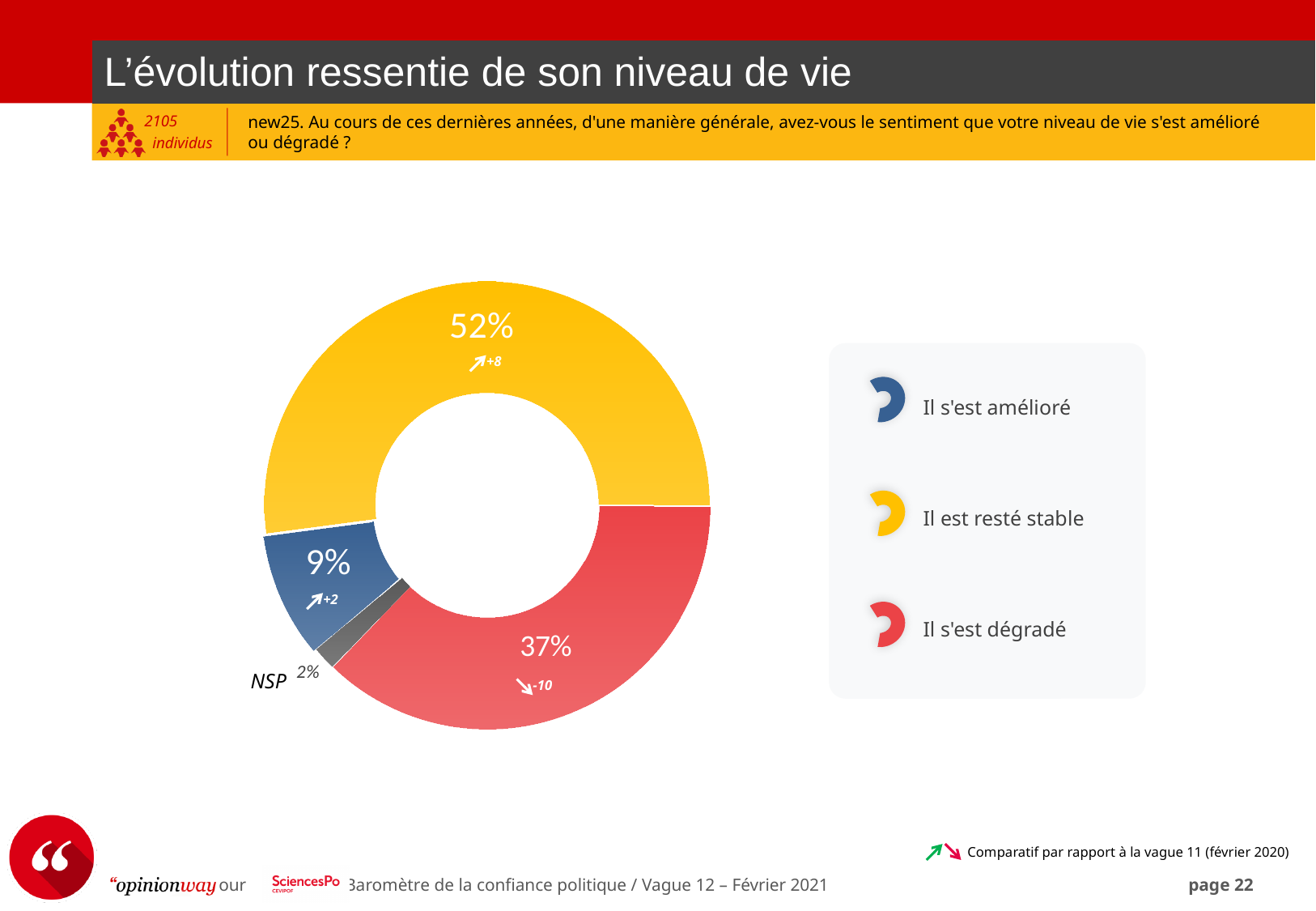
What change compared with the previous wave is shown next to the 37% slice? -10 What percentage is shown for NSP? 2% What kind of chart is shown on the slide? Donut (pie) chart What is the difference in percentage points between "Il est resté stable" and "Il s'est dégradé"? 15 Which colour represents "Il s'est amélioré" in the legend? Blue What percentage of respondents say their standard of living has deteriorated ("Il s'est dégradé")? 37% How many slices does the chart have? 4 Which response category has the smallest share of the chart? NSP Which is larger: the share for "Il s'est amélioré" or the share for "Il s'est dégradé"? Il s'est dégradé What percentage of respondents say their standard of living has remained stable ("Il est resté stable")? 52% What percentage of respondents say their standard of living has improved ("Il s'est amélioré")? 9% Which response category has the largest share of the chart? Il est resté stable